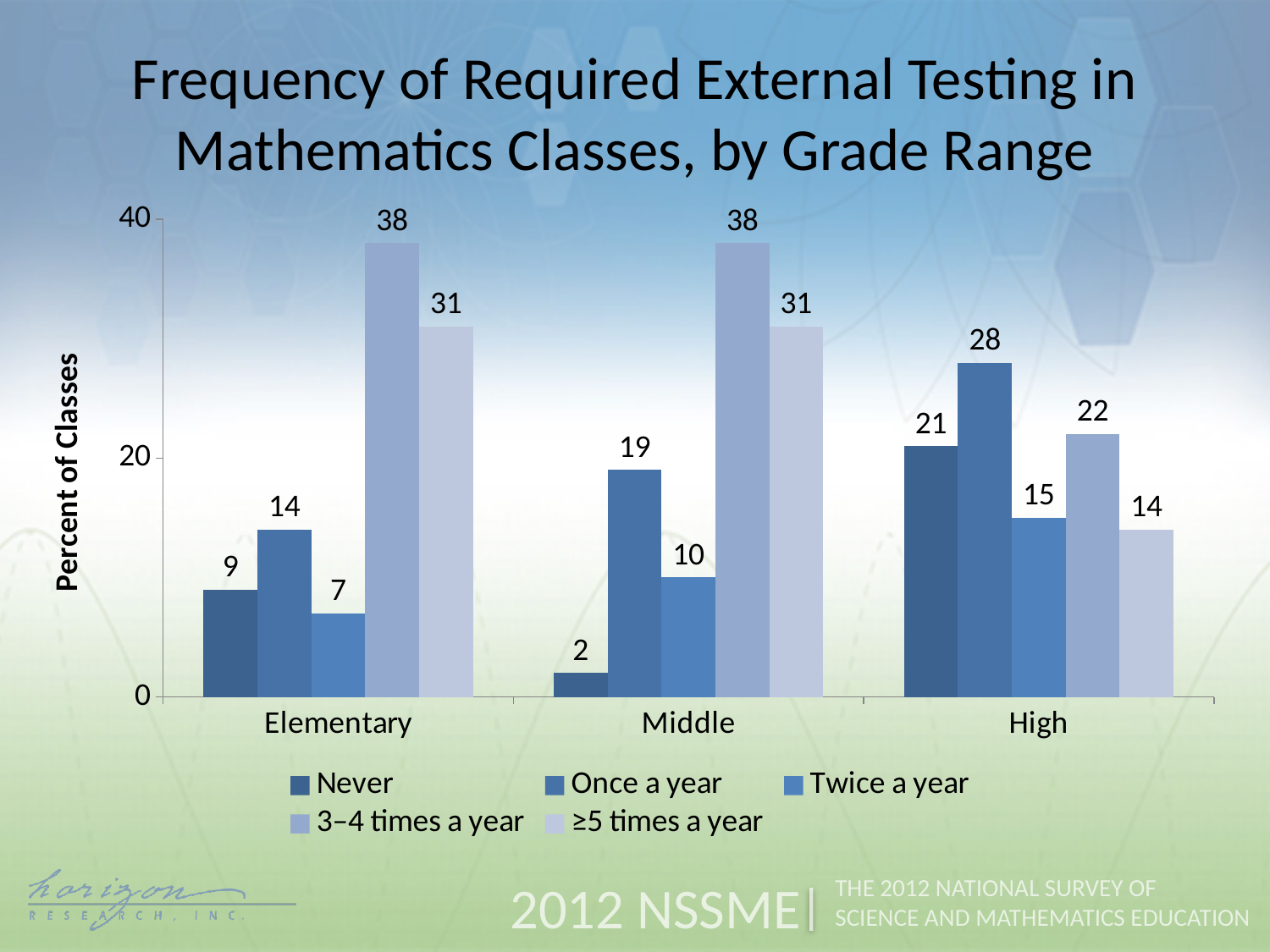
What is the difference between the '3–4 times a year' values for Middle and High? 16 How many series does the legend list? 5 What is the value for 'Once a year' in the Middle grade range? 19 Which grade range has the highest value for 'Never'? High What percent of Elementary mathematics classes report 'Never' for required external testing? 9 What is the label of the y axis? Percent of Classes What kind of chart is shown on the slide? Bar chart Is the value for '3–4 times a year' in Elementary greater or less than 20? greater What is the value for '≥5 times a year' in the High grade range? 14 Which is larger: 'Once a year' for High or '3–4 times a year' for High? Once a year for High Which grade range has the lowest value for 'Twice a year'? Elementary How many grade ranges are shown on the x axis? 3